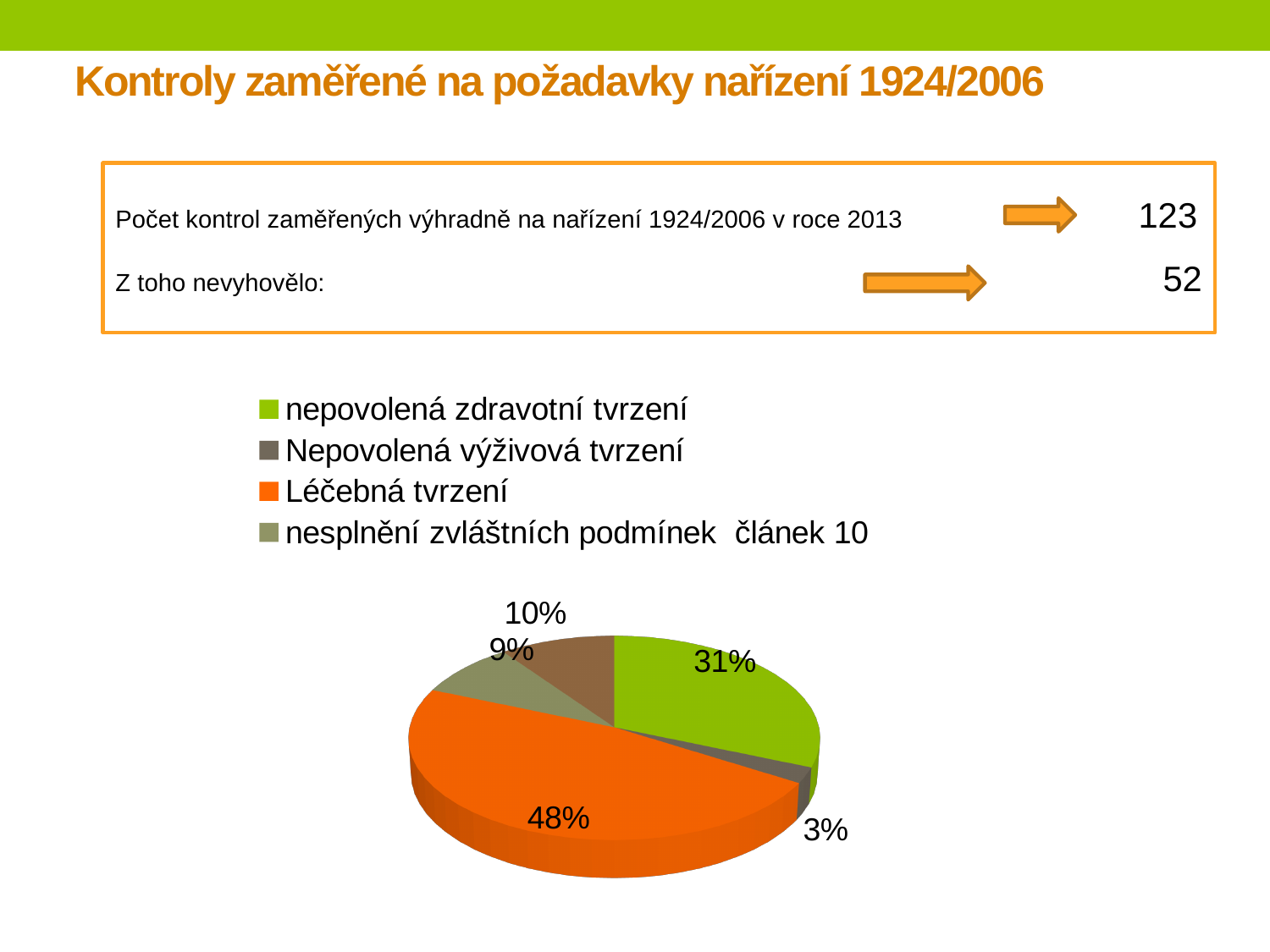
What share of the pie is labelled for 'nepovolená zdravotní tvrzení'? 31% What share of the pie is labelled for 'Nepovolená výživová tvrzení'? 3% How many entries does the chart legend list? 4 What colour is the 'Léčebná tvrzení' slice in the pie chart? orange What share of the pie is labelled for 'Léčebná tvrzení'? 48% What share of the pie is labelled for 'nesplnění zvláštních podmínek článek 10'? 9% What kind of chart is shown on the slide? pie chart Which slice is larger: 'nepovolená zdravotní tvrzení' or 'Léčebná tvrzení'? Léčebná tvrzení Which legend category has the largest slice of the pie? Léčebná tvrzení Which legend category has the smallest slice of the pie? Nepovolená výživová tvrzení How many percentage points larger is the 'nepovolená zdravotní tvrzení' slice than the 'nesplnění zvláštních podmínek článek 10' slice? 22 percentage points How many percentage points larger is the 'Léčebná tvrzení' slice than the 'nepovolená zdravotní tvrzení' slice? 17 percentage points